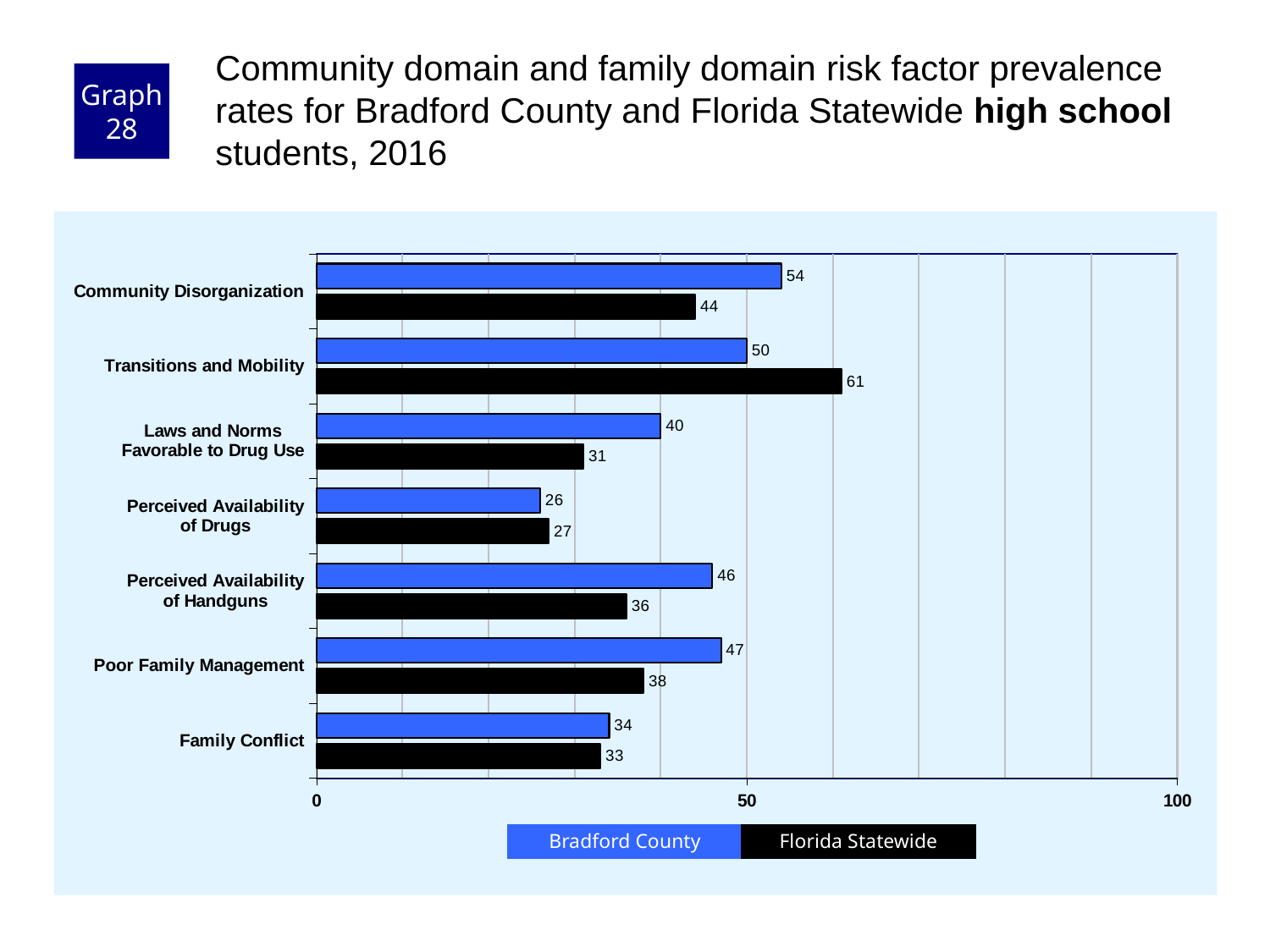
Which risk factor has the lowest Bradford County value? Perceived Availability of Drugs How many series does the legend list? 2 What kind of chart is shown on the slide? Bar chart What is the Florida Statewide value for Perceived Availability of Handguns? 36 How many risk factors are shown on the chart? 7 What is the difference between the Bradford County and Florida Statewide values for Laws and Norms Favorable to Drug Use? 9 Which risk factor has the highest Florida Statewide value? Transitions and Mobility What is the Florida Statewide value for Transitions and Mobility? 61 For Poor Family Management, which is larger: the Bradford County value or the Florida Statewide value? Bradford County Which colour represents Florida Statewide in the chart? Black Which risk factor has the highest Bradford County value? Community Disorganization What is the Bradford County value for Community Disorganization? 54